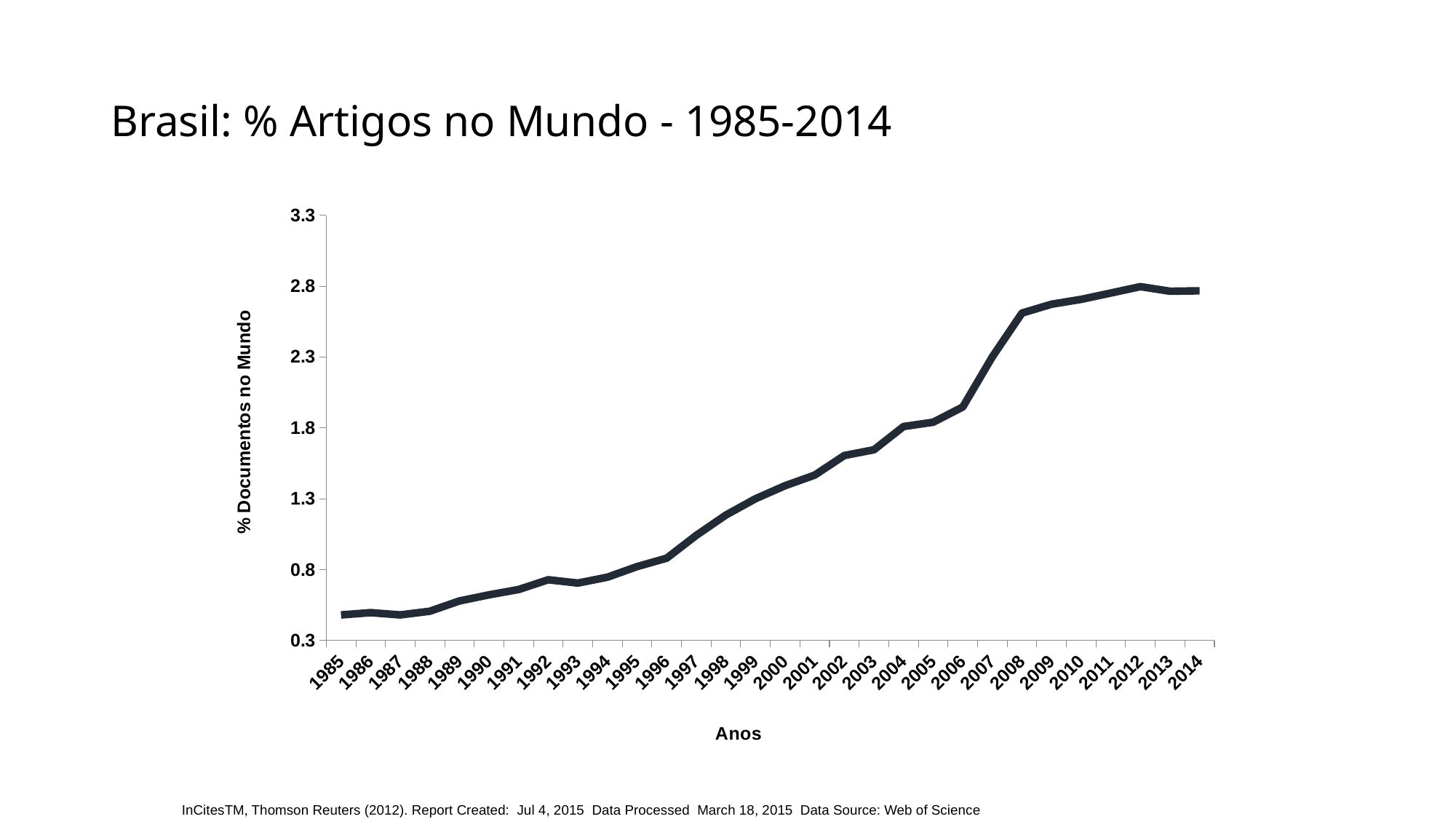
What is the label of the y axis? % Documentos no Mundo Which year has the larger value, 1996 or 2008? 2008 What is the title of the chart? Brasil: % Artigos no Mundo - 1985-2014 Is the value for 2006 greater or less than 1.8? greater How many years are plotted along the x axis? 30 Is the value for 2008 greater or less than 2.3? greater What kind of chart is shown on the slide? line chart Is the value for 1998 greater or less than 1.3? less Which year has the larger value, 2002 or 1990? 2002 Do the values generally rise or fall from 1985 to 2014? rise